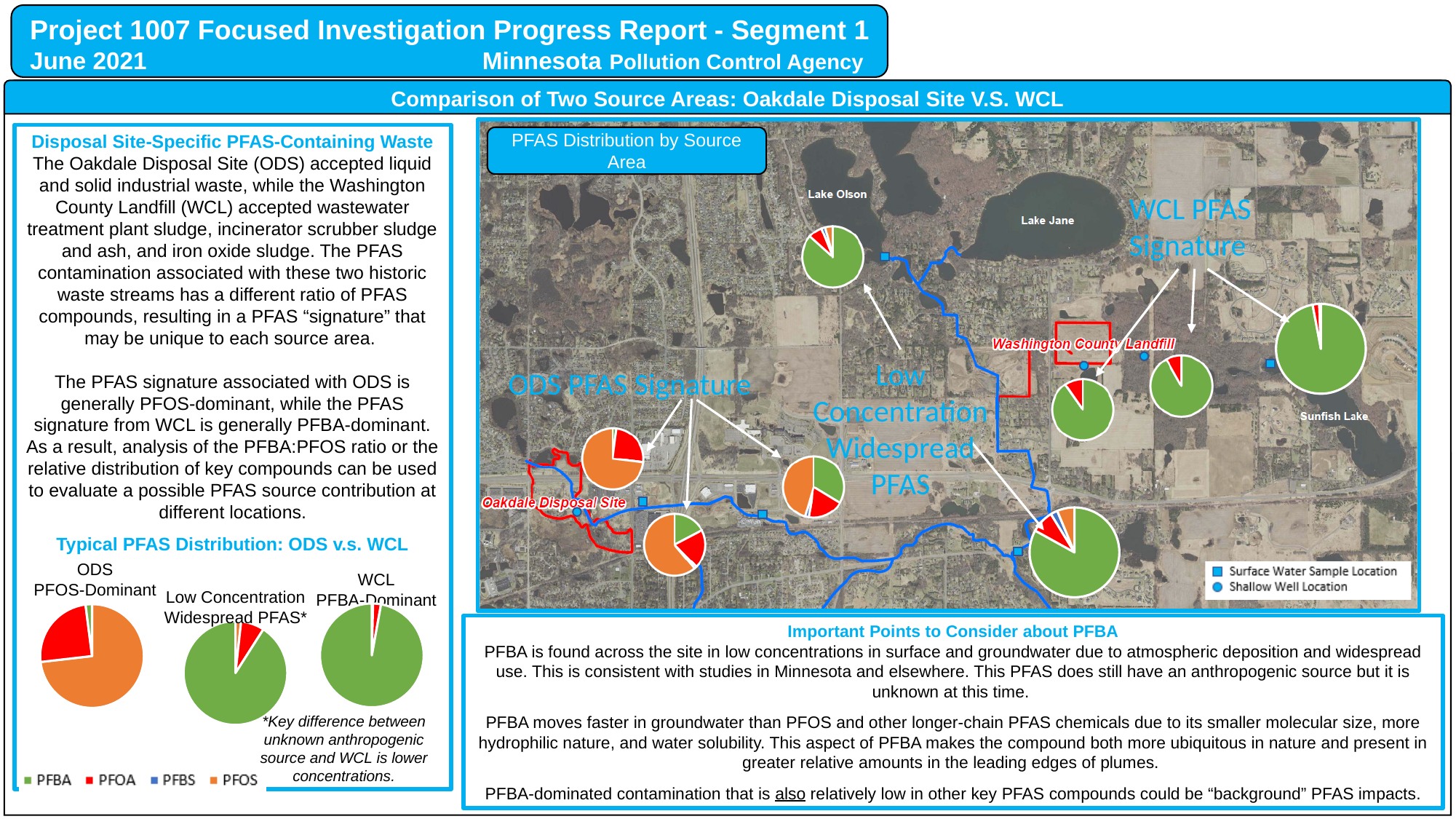
In the 'WCL PFBA-Dominant' pie chart, which compound has the largest slice? PFBA What kind of charts are used in the 'Typical PFAS Distribution: ODS v.s. WCL' section? Pie charts Which colour represents PFOS in the legend of the 'Typical PFAS Distribution' pie charts? Orange In the 'ODS PFOS-Dominant' pie chart, which slice is larger, PFOA or PFBA? PFOA How many PFAS compounds does the legend below the 'Typical PFAS Distribution' pie charts list? 4 How many pie charts are shown in the 'Typical PFAS Distribution: ODS v.s. WCL' section? 3 On the 'PFAS Distribution by Source Area' map, which compound has the largest slice in the pie chart next to the Oakdale Disposal Site? PFOS In the 'WCL PFBA-Dominant' pie chart, which slice is larger, PFBA or PFOA? PFBA Which compound is shown in green in the legend of the 'Typical PFAS Distribution' pie charts? PFBA In the 'ODS PFOS-Dominant' pie chart, which slice is larger, PFOS or PFOA? PFOS In the 'ODS PFOS-Dominant' pie chart, which compound has the largest slice? PFOS